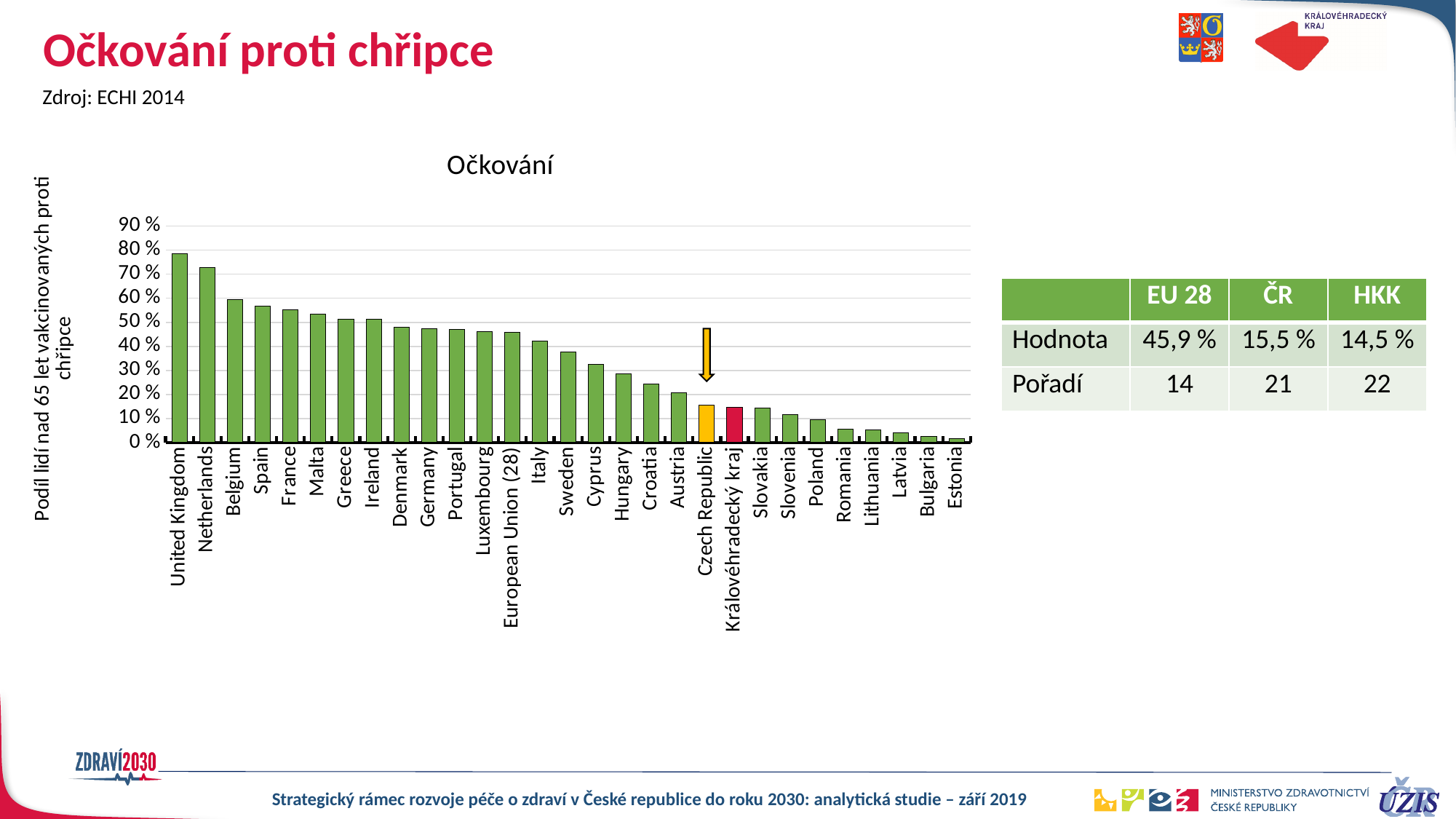
What colour is the bar for Královéhradecký kraj? red Is the value for United Kingdom greater or less than 70 %? greater Is the value for Romania greater or less than 10 %? less According to the table, what is the value (Hodnota) for EU 28? 45,9 % Do the values rise or fall moving from left to right along the x axis? fall What kind of chart is shown on the slide? bar chart Which is larger, the value for Belgium or the value for Malta? Belgium Which country has the highest vaccination share in the chart? United Kingdom Is the value for Sweden greater or less than 40 %? less Which category has the lowest value in the chart? Estonia How many categories (bars) are plotted in the chart? 29